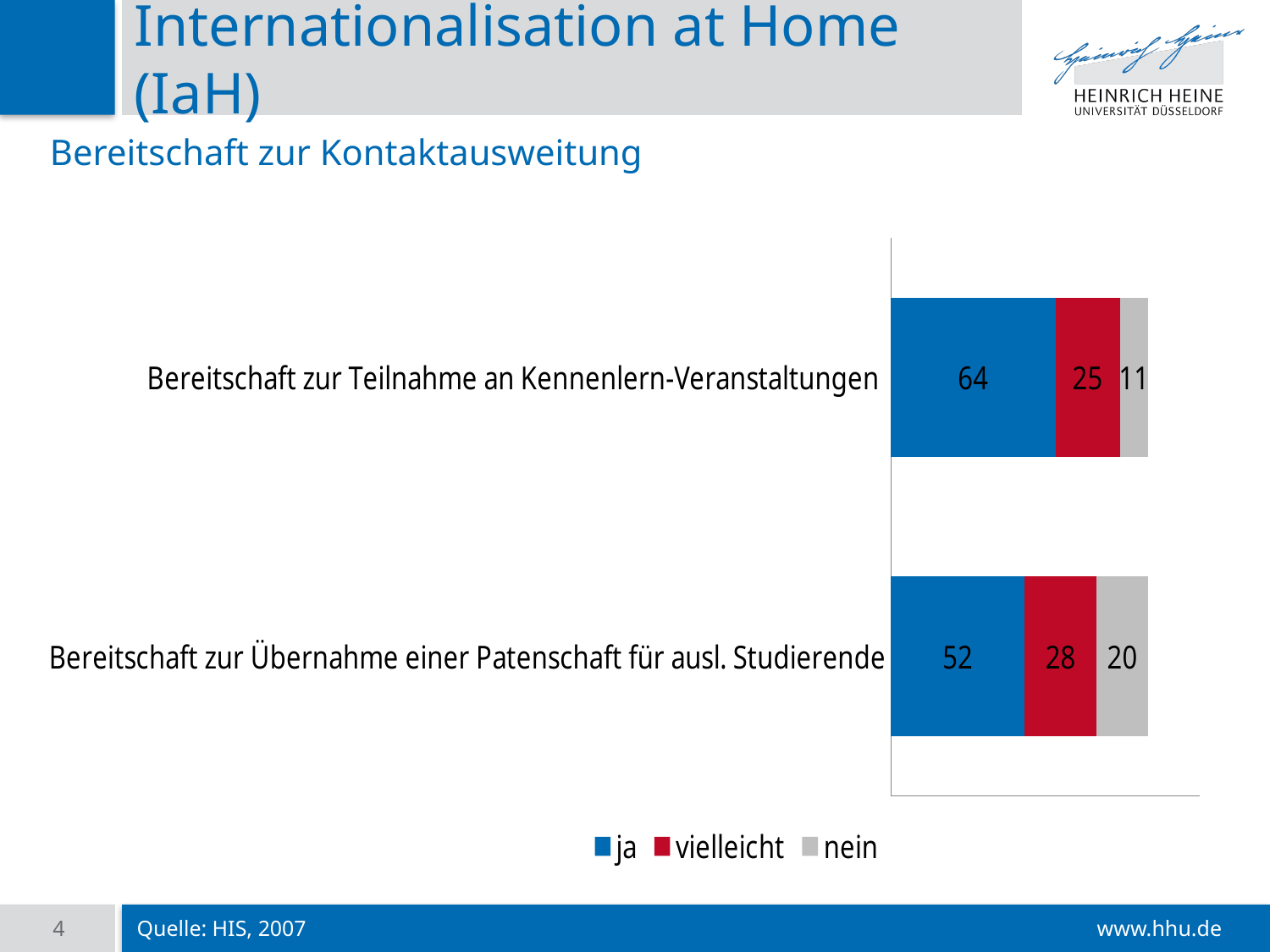
Which category has the higher "ja" value? Bereitschaft zur Teilnahme an Kennenlern-Veranstaltungen What is the total of the stacked bar for "Bereitschaft zur Teilnahme an Kennenlern-Veranstaltungen"? 100 How many series does the legend list? 3 What is the value for "vielleicht" for "Bereitschaft zur Teilnahme an Kennenlern-Veranstaltungen"? 25 What is the value for "ja" for "Bereitschaft zur Übernahme einer Patenschaft für ausl. Studierende"? 52 What is the difference between the "ja" values of the two categories? 12 What is the value for "ja" for "Bereitschaft zur Teilnahme an Kennenlern-Veranstaltungen"? 64 What is the value for "nein" for "Bereitschaft zur Übernahme einer Patenschaft für ausl. Studierende"? 20 What kind of chart is shown on the slide? Stacked bar chart How many categories are shown in the chart? 2 Which category has the lower "nein" value? Bereitschaft zur Teilnahme an Kennenlern-Veranstaltungen Is the "vielleicht" value larger for "Bereitschaft zur Teilnahme an Kennenlern-Veranstaltungen" or for "Bereitschaft zur Übernahme einer Patenschaft für ausl. Studierende"? Bereitschaft zur Übernahme einer Patenschaft für ausl. Studierende